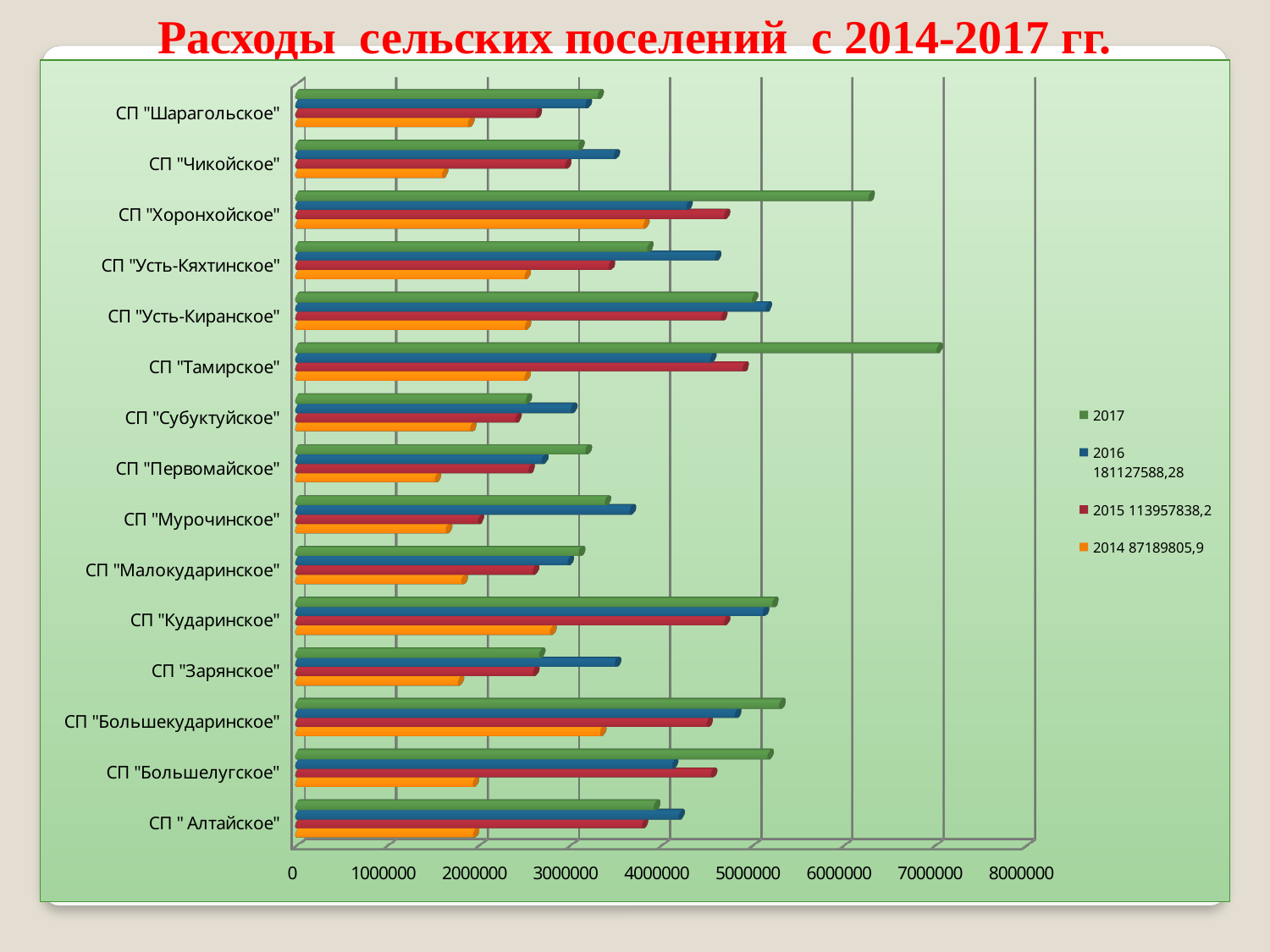
Is the 2014 value for СП "Первомайское" greater or less than 2000000? less Which is larger for СП "Мурочинское": the 2015 value or the 2016 value? 2016 Which settlement has the highest value for 2014? СП "Хоронхойское" What kind of chart is shown on the slide? bar chart What is the full legend entry for the 2016 series? 2016 181127588,28 How many series does the legend list? 4 What is the title of the slide? Расходы сельских поселений с 2014-2017 гг. How many settlements (categories) are shown on the chart? 15 Which settlement has the highest value for 2017? СП "Тамирское" Which is larger for СП "Зарянское": the 2016 value or the 2017 value? 2016 Is the 2017 value for СП "Хоронхойское" greater or less than 5000000? greater Is the 2017 value for СП "Тамирское" greater or less than 6000000? greater